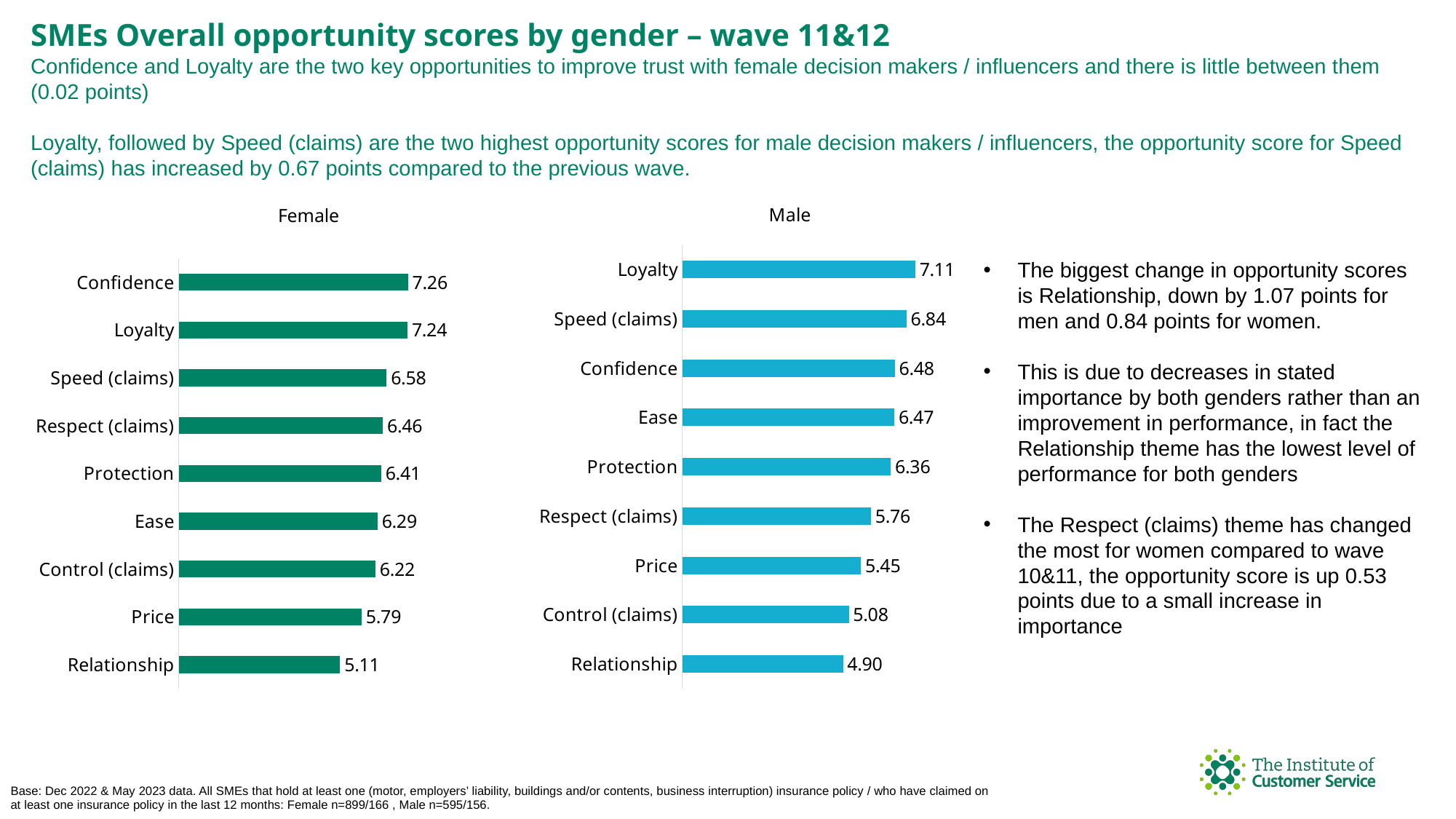
In the Female chart, what is the opportunity score for Confidence? 7.26 What type of chart is used for the Male scores? Bar chart In the Male chart, which is larger, the score for Ease or the score for Price? Ease How many categories are shown in the Female chart? 9 Is the score for Price higher in the Female chart or the Male chart? Female In the Male chart, what is the opportunity score for Speed (claims)? 6.84 In the Female chart, which category has the lowest opportunity score? Relationship In the Male chart, which category has the highest opportunity score? Loyalty In the Male chart, what is the opportunity score for Relationship? 4.90 In the Male chart, what is the difference between the scores for Loyalty and Relationship? 2.21 What colour are the bars in the Female chart? Dark green In the Female chart, what is the difference between the scores for Confidence and Loyalty? 0.02